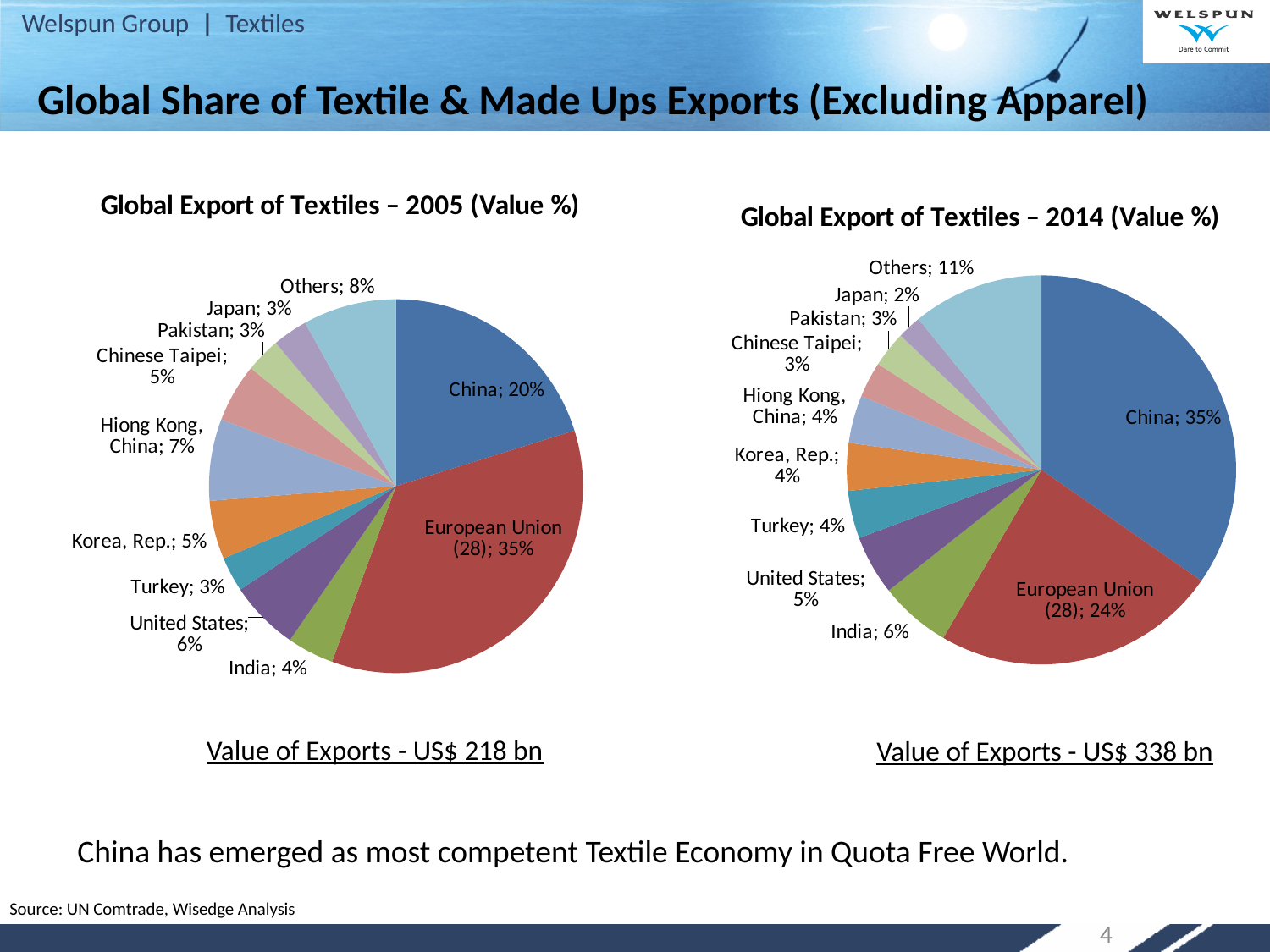
In the 'Global Export of Textiles – 2005 (Value %)' chart, what share does China have? 20% In the 'Global Export of Textiles – 2005 (Value %)' chart, what is the share of Hiong Kong, China? 7% How many slices does the 'Global Export of Textiles – 2005 (Value %)' pie chart have? 11 In the 'Global Export of Textiles – 2005 (Value %)' chart, which category has the largest slice? European Union (28) In the 'Global Export of Textiles – 2014 (Value %)' chart, which category has the smallest slice? Japan In the 'Global Export of Textiles – 2014 (Value %)' chart, what is the share of India? 6% In the 'Global Export of Textiles – 2005 (Value %)' chart, what is the difference between the European Union (28) share and the China share? 15% In the 'Global Export of Textiles – 2014 (Value %)' chart, what share does China have? 35% In the 'Global Export of Textiles – 2005 (Value %)' chart, what is the share of European Union (28)? 35% In the 'Global Export of Textiles – 2014 (Value %)' chart, which category has the largest slice? China In the 'Global Export of Textiles – 2014 (Value %)' chart, which is larger, the share of Others or the share of India? Others What type of chart is used for 'Global Export of Textiles – 2014 (Value %)'? Pie chart